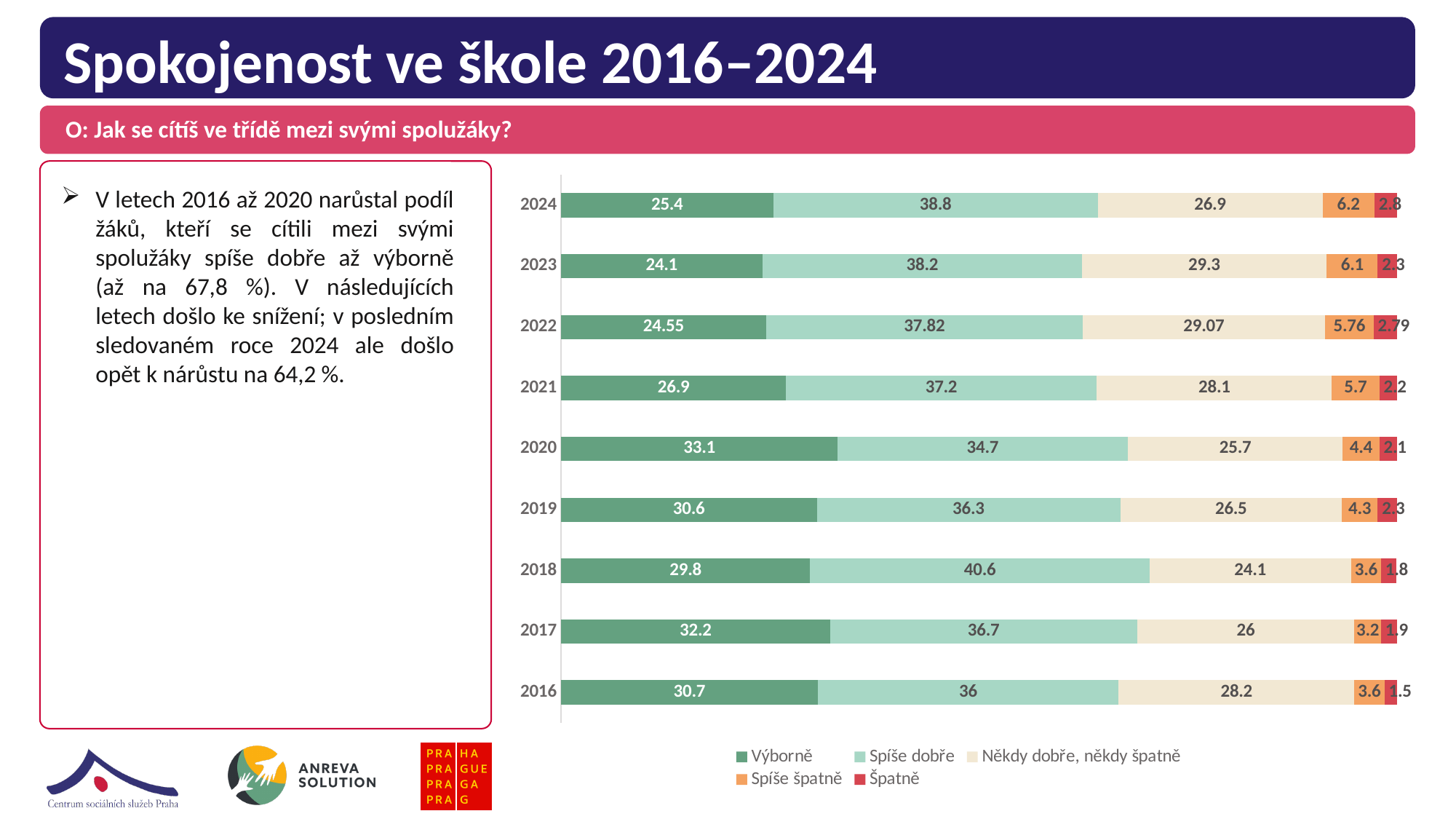
What is the value for 'Spíše dobře' in 2018? 40.6 What kind of chart is shown on the slide? Stacked bar chart What is the value for 'Někdy dobře, někdy špatně' in 2022? 29.07 What is the total of the stacked bar for 2016? 100 In which year is the 'Výborně' value lowest? 2023 How many years (categories) are plotted in the chart? 9 In which year is the 'Špatně' value lowest? 2016 How many series does the chart legend list? 5 What is the value for 'Výborně' in 2024? 25.4 In which year is the 'Výborně' value highest? 2020 What is the difference between the 'Výborně' value in 2020 and in 2024? 7.7 Which is larger: the 'Spíše dobře' value in 2018 or in 2016? 2018